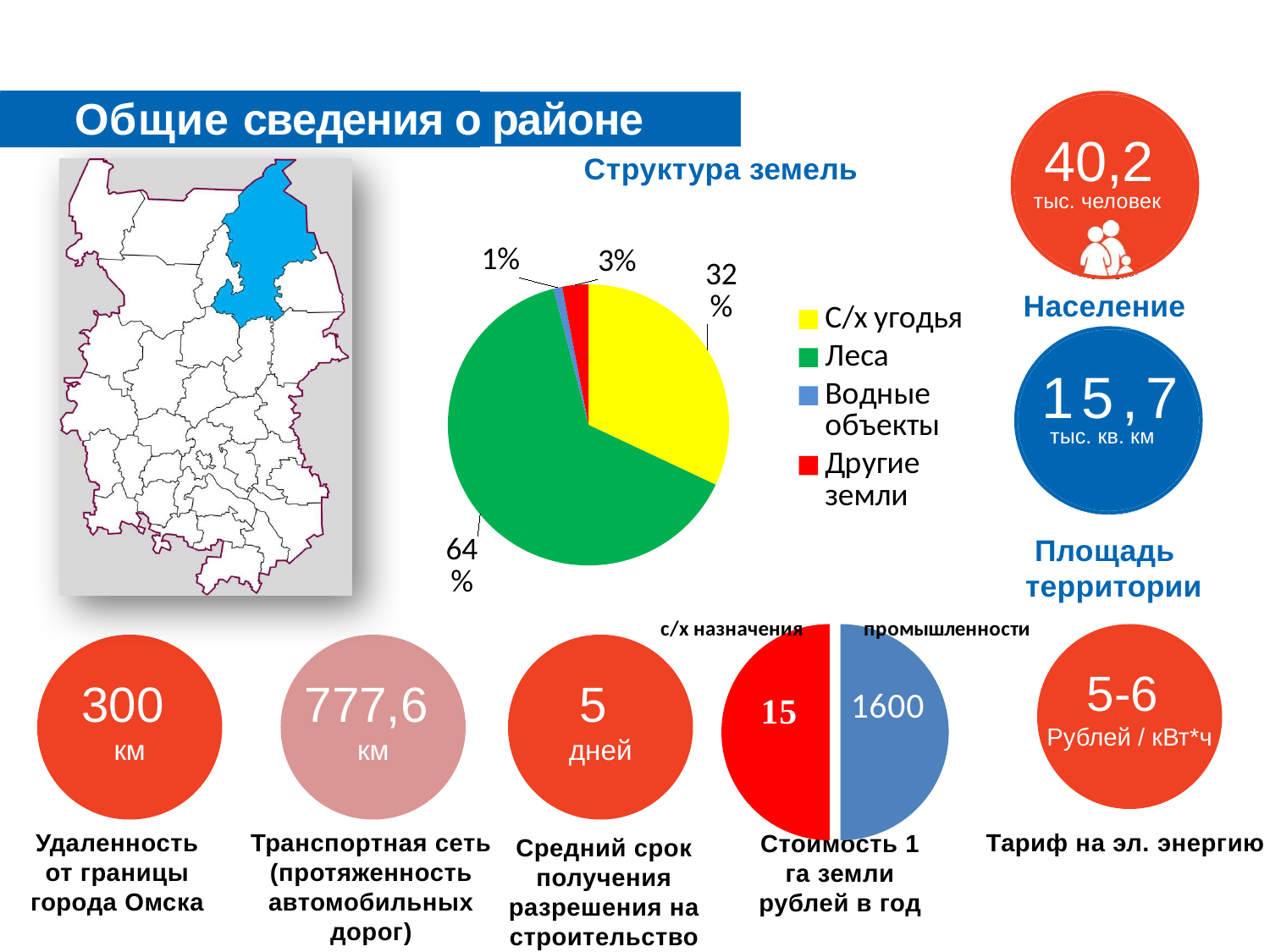
In the 'Структура земель' chart, which category has the smallest share? Водные объекты In the 'Структура земель' chart, what share of land is 'С/х угодья'? 32% In the 'Структура земель' chart, which category has the largest share? Леса In the 'Структура земель' chart, what colour represents 'Леса'? Green In the 'Структура земель' chart, what is the difference in percentage points between 'Леса' and 'С/х угодья'? 32 In the 'Структура земель' chart, what share of land is 'Леса'? 64% What type of chart is 'Структура земель'? Pie chart In the 'Структура земель' chart, which is larger: 'Другие земли' or 'Водные объекты'? Другие земли How many categories does the legend of the 'Структура земель' chart list? 4 In the 'Стоимость 1 га земли рублей в год' chart, what is the value for 'промышленности'? 1600 In the 'Структура земель' chart, what share of land is 'Другие земли'? 3% In the 'Структура земель' chart, what share of land is 'Водные объекты'? 1%